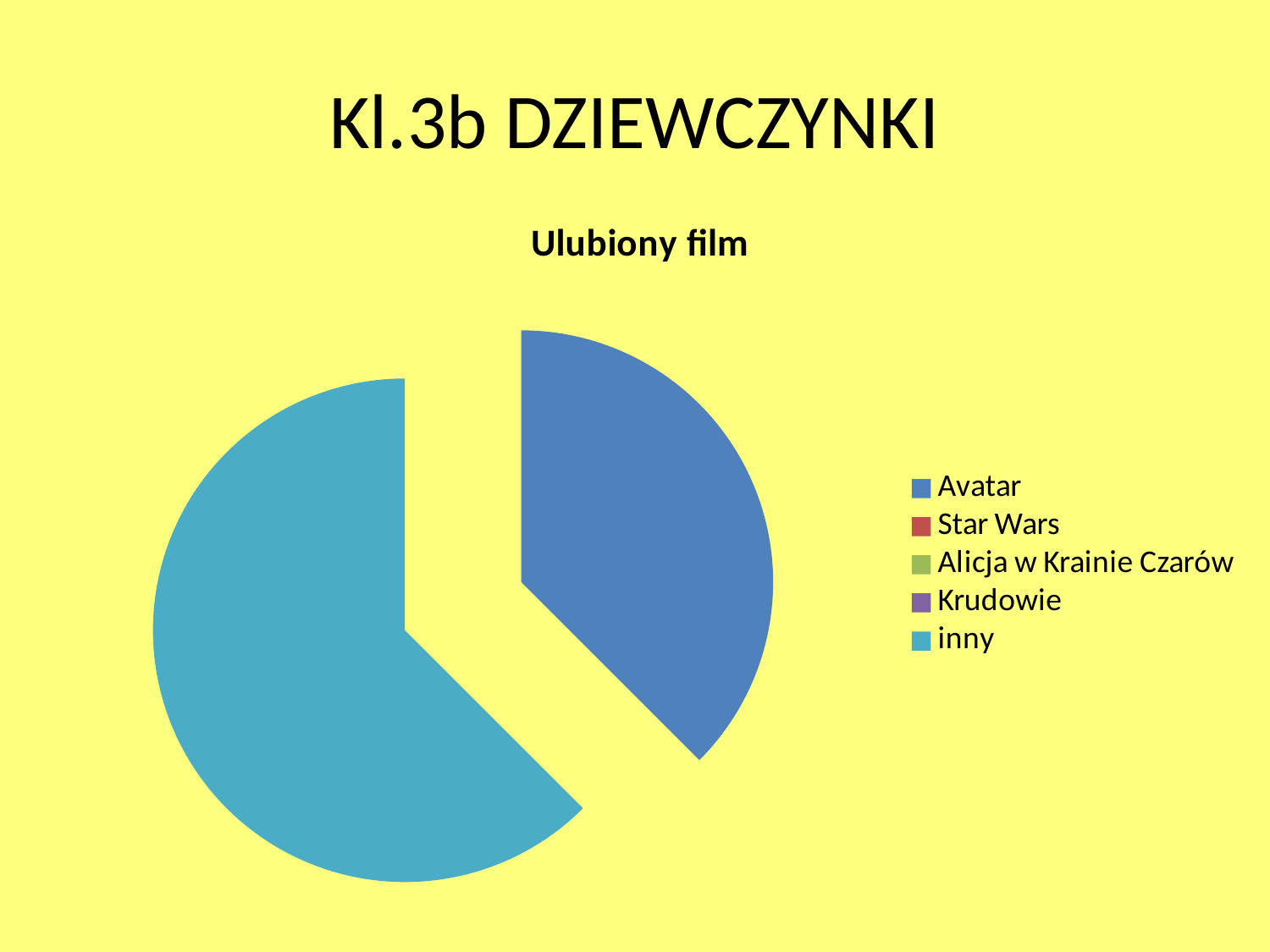
Which legend entry is listed last? inny What is the title of the chart? Ulubiony film What kind of chart is shown on the slide? pie chart Which legend entry is shown in the darker blue colour? Avatar Is the inny slice more or less than half of the pie? more Which slice is larger, Avatar or inny? inny How many entries does the chart's legend list? 5 How many slices are visible in the pie? 2 Which category has the largest slice of the pie? inny Is the Avatar slice more or less than half of the pie? less